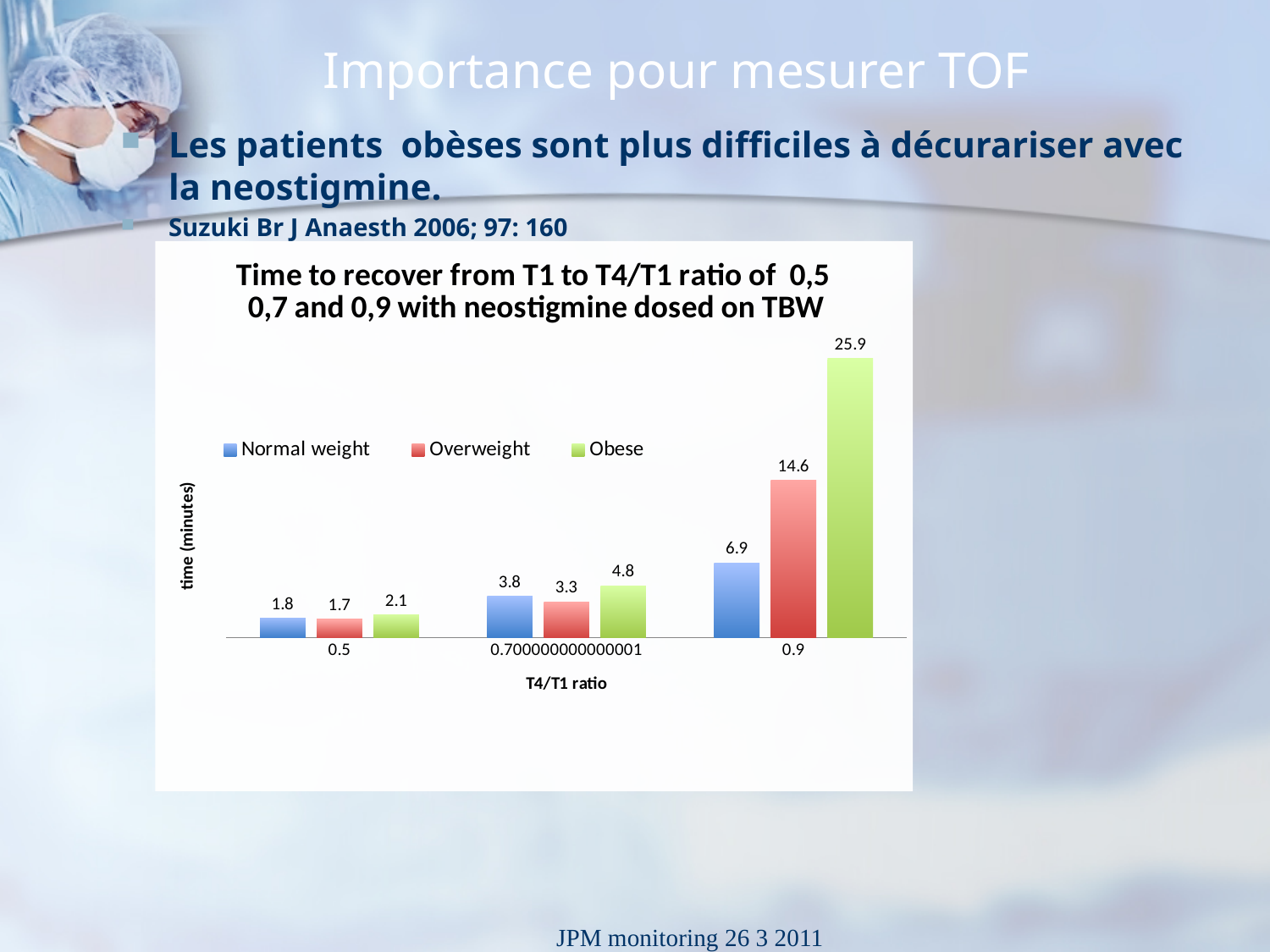
How many T4/T1 ratio categories are shown on the x axis? 3 What is the label of the y axis? time (minutes) How many series does the chart legend list? 3 Which weight group has the lowest recovery time at a T4/T1 ratio of 0.5? Overweight What is the recovery time for Normal weight patients at a T4/T1 ratio of 0.5? 1.8 Which is larger at the middle category (labelled 0.700000000000001): the Obese value or the Normal weight value? Obese What is the recovery time for Overweight patients at the middle category (labelled 0.700000000000001)? 3.3 Which weight group has the highest recovery time at a T4/T1 ratio of 0.9? Obese What type of chart is shown on the slide? bar chart What is the recovery time for Obese patients at a T4/T1 ratio of 0.9? 25.9 How does the Obese recovery time change as the T4/T1 ratio increases from 0.5 to 0.9? It rises What is the difference between the Obese and Normal weight recovery times at a T4/T1 ratio of 0.9? 19